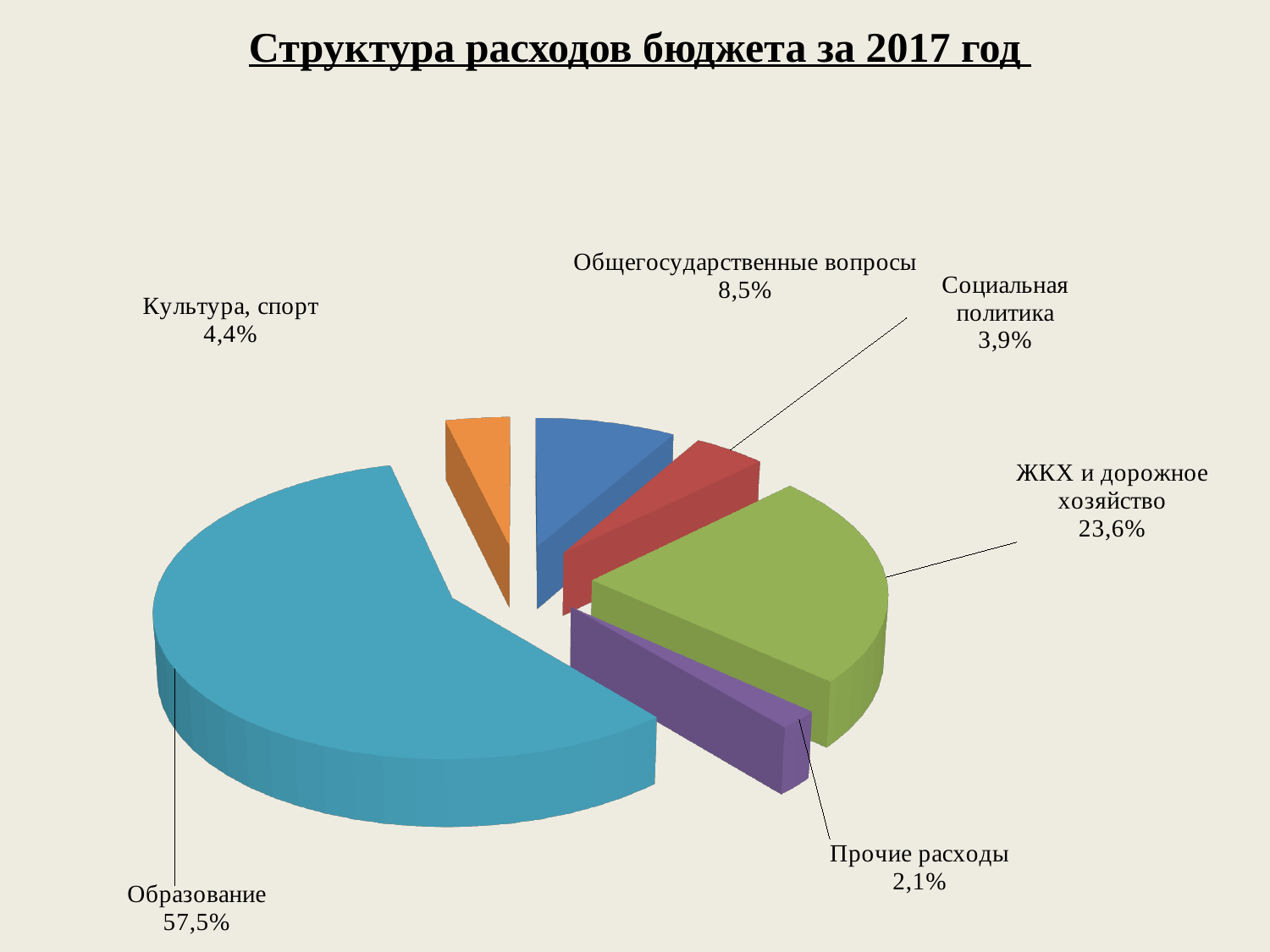
Which category has the largest share of budget expenditure? Образование What share of budget expenditure is Прочие расходы? 2,1% What share of budget expenditure is Социальная политика? 3,9% Which category has the smallest share of budget expenditure? Прочие расходы What type of chart is shown on the slide? Pie chart What is the title of the chart? Структура расходов бюджета за 2017 год What share of budget expenditure is Образование? 57,5% How many categories are shown in the pie chart? 6 What share of budget expenditure is Общегосударственные вопросы? 8,5% Which is larger, the share for Культура, спорт or the share for Социальная политика? Культура, спорт What is the difference in percentage points between Образование and ЖКХ и дорожное хозяйство? 33,9 What share of budget expenditure is ЖКХ и дорожное хозяйство? 23,6%